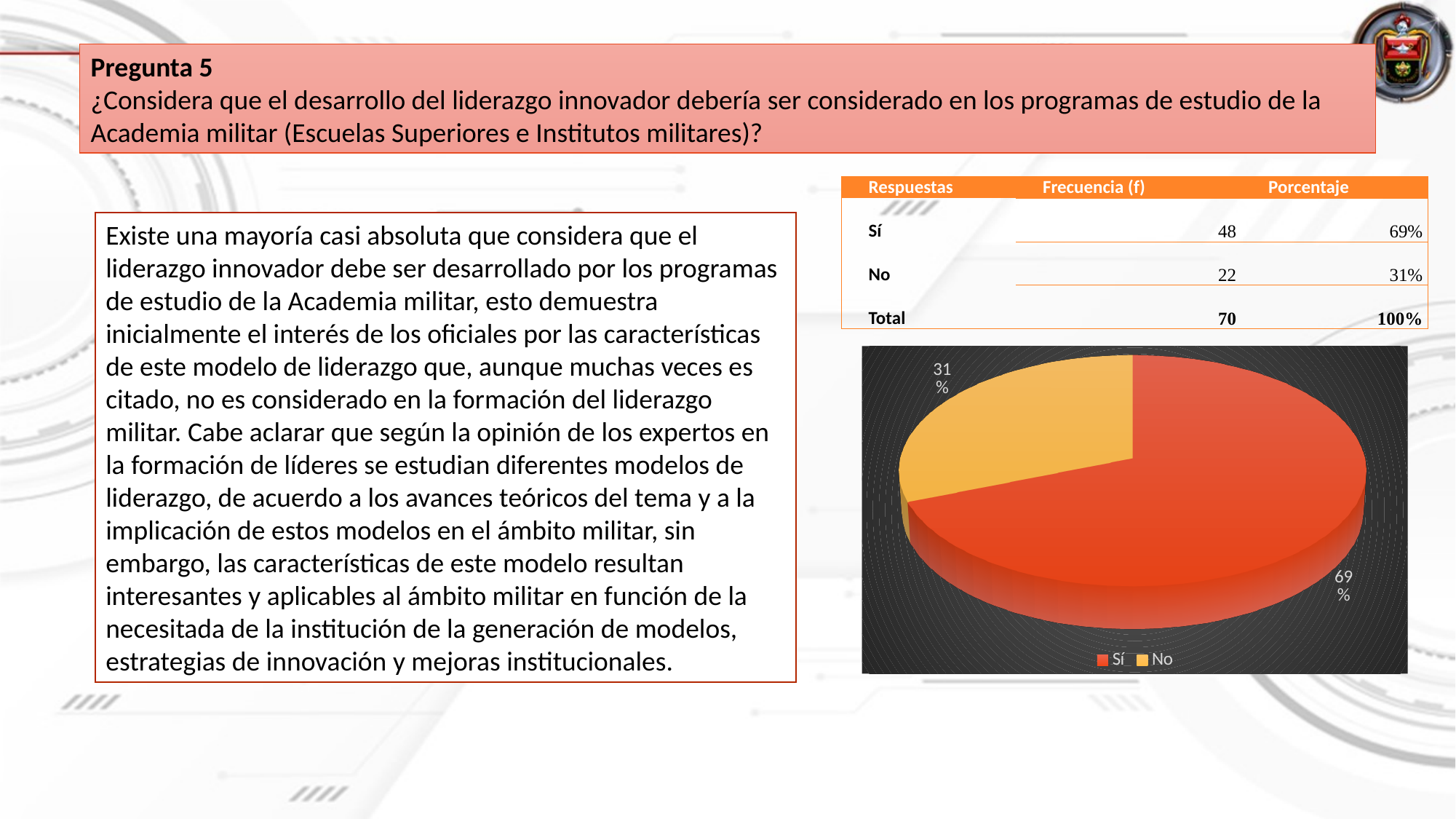
What percentage does the pie chart show for No? 31% What kind of chart is shown on the slide? Pie chart What percentage does the pie chart show for Sí? 69% Which category has the smallest slice in the pie chart? No What colour is the Sí slice in the pie chart? Red What colour is the No slice in the pie chart? Yellow How many slices does the pie chart have? 2 What share of the pie does the No slice represent? 31% How many entries does the legend of the pie chart list? 2 What is the difference in percentage points between the Sí and No slices? 38 Which slice is larger, Sí or No? Sí Which category has the largest slice in the pie chart? Sí